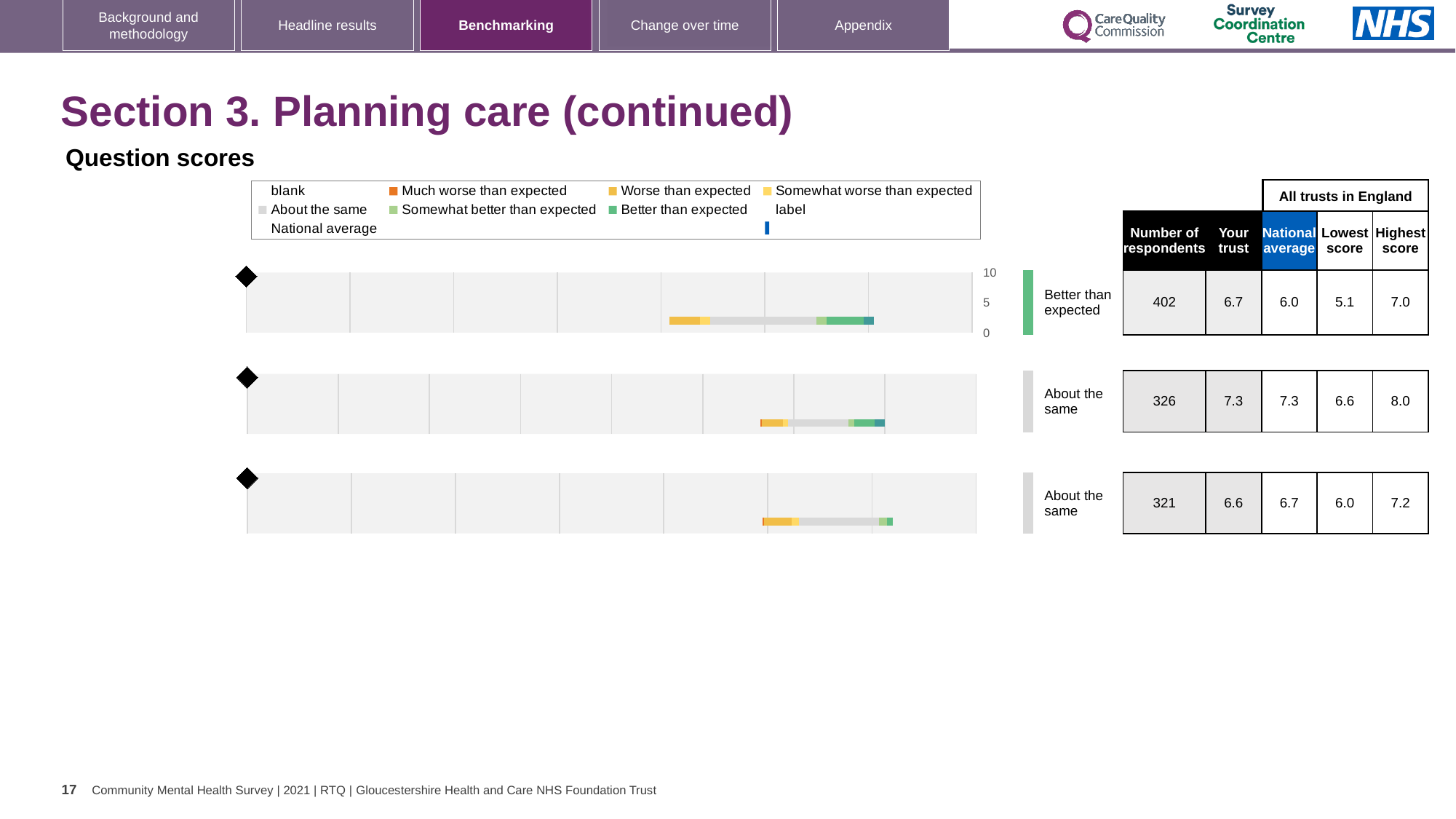
For the bottom chart's row, what is the national average score? 6.7 What kind of chart is used for the three question score displays on the slide? bar chart Which legend entry is shown with a dark orange colour? Much worse than expected What benchmark category is shown next to the bottom chart? About the same What is the maximum value shown on the vertical axis of the top chart? 10 Which row has the higher 'Your trust' score, the top chart's row or the bottom chart's row? top chart's row What benchmark category is shown next to the middle chart? About the same How many question score charts are shown on the slide? 3 For the top chart's row, what is the difference between the highest score and the lowest score across all trusts in England? 1.9 What benchmark category is shown next to the top chart? Better than expected For the top chart's row, what is the 'Your trust' score? 6.7 For the middle chart's row, what is the number of respondents? 326